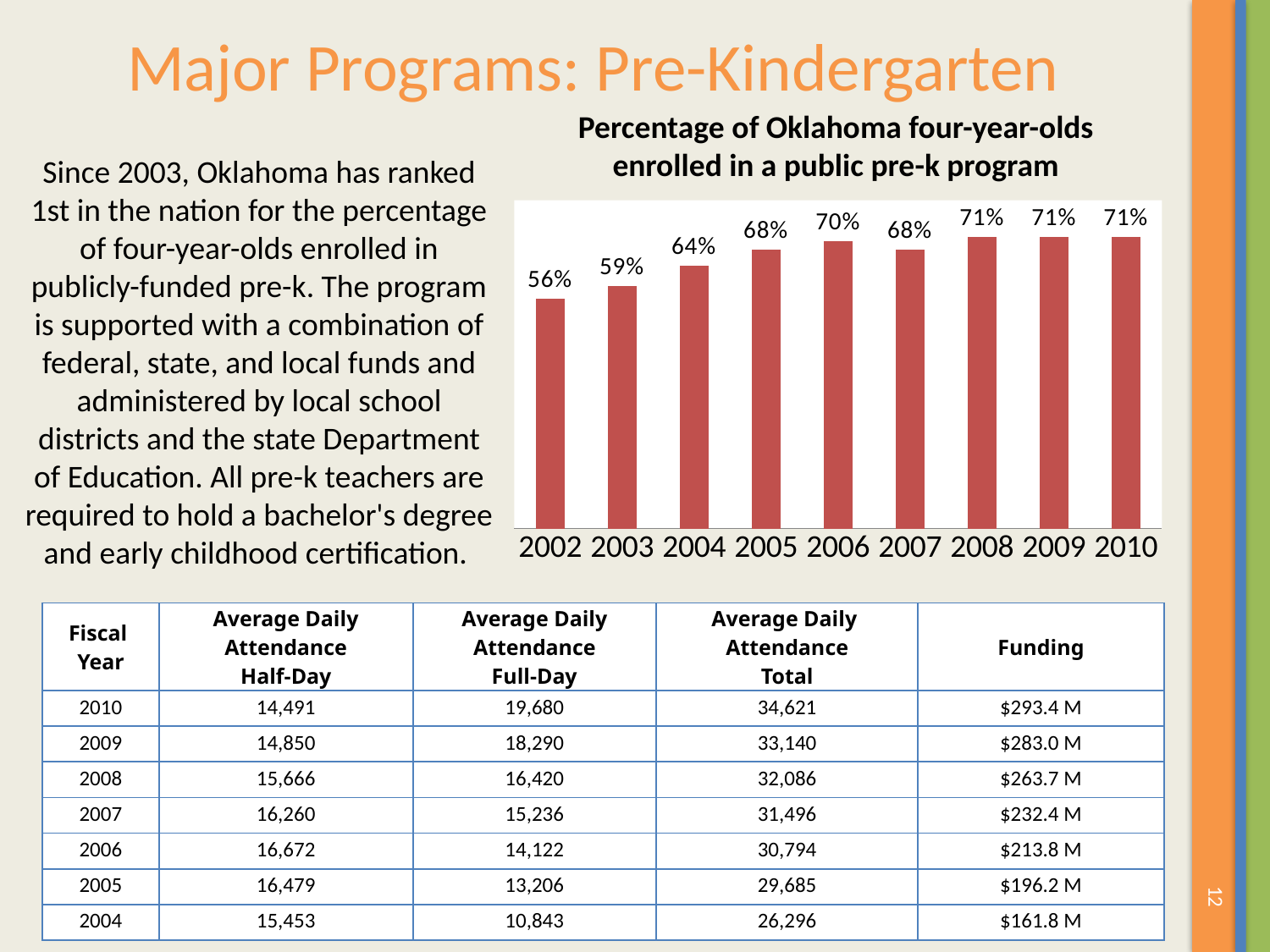
What percentage is shown for 2004 in the chart? 64% Which year has the lowest percentage of four-year-olds enrolled in public pre-k? 2002 What is the title of the chart on the slide? Percentage of Oklahoma four-year-olds enrolled in a public pre-k program What is the highest percentage shown in the chart? 71% What type of chart is used to show the pre-k enrollment percentages? Bar chart What is the difference between the 2005 and 2003 values in the chart? 9 percentage points How many years are shown on the x axis of the chart? 9 By how many percentage points did enrollment increase from 2002 to 2010? 15 percentage points What is the value shown for 2006 in the pre-k enrollment chart? 70% What percentage of Oklahoma four-year-olds were enrolled in a public pre-k program in 2002? 56% Do the enrollment percentages generally rise or fall from 2002 to 2010? Rise Which year has the higher value in the chart, 2006 or 2007? 2006